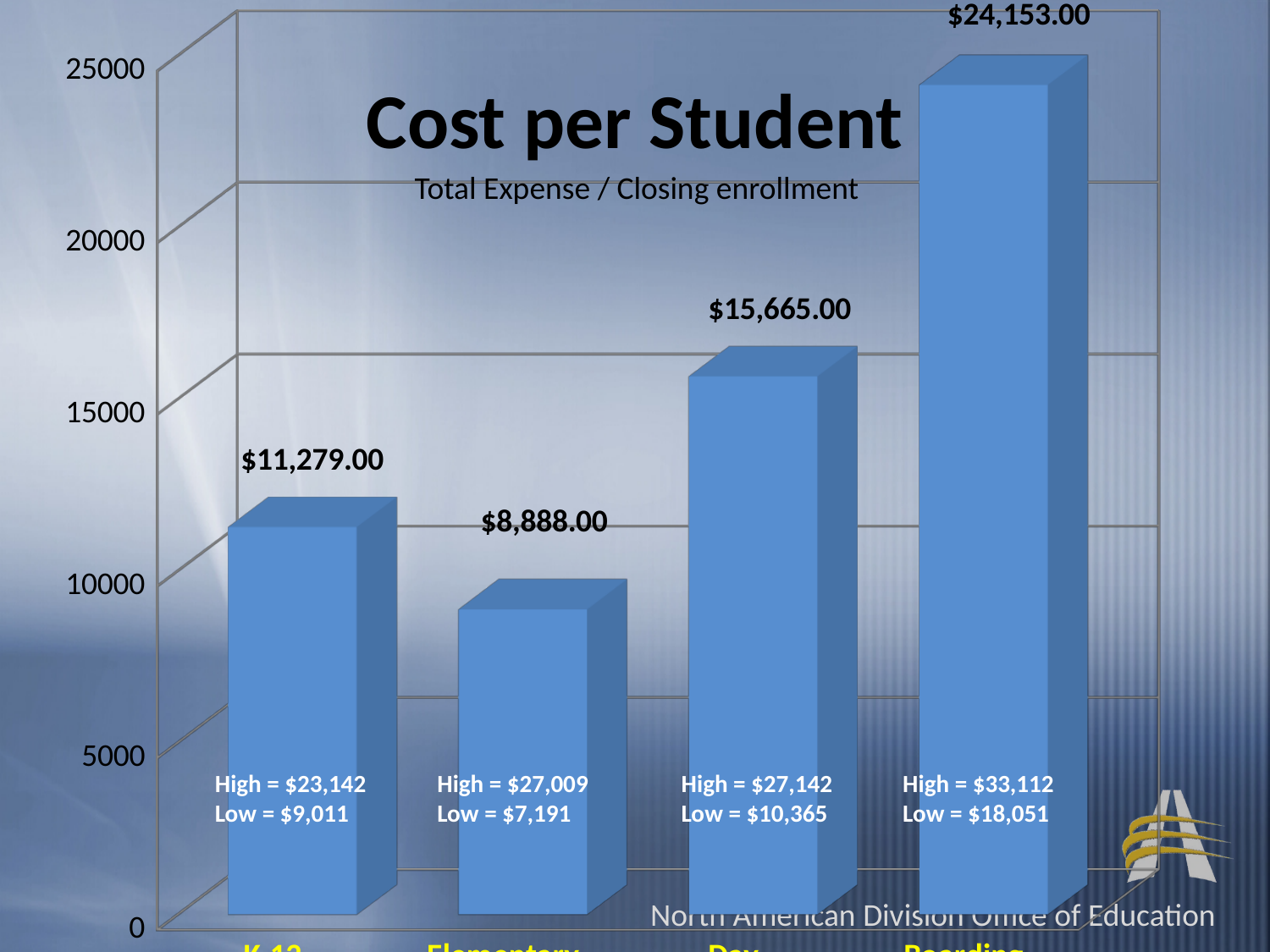
What is the value of the leftmost bar in the Cost per Student chart? $11,279.00 What is the subtitle shown under the chart title Cost per Student? Total Expense / Closing enrollment Which bar in the Cost per Student chart has the highest value? The rightmost (fourth) bar, $24,153.00 What is the value of the second bar from the left in the Cost per Student chart? $8,888.00 What is the value of the third bar from the left in the Cost per Student chart? $15,665.00 What type of chart is shown on the slide? Bar chart What is the value of the rightmost bar in the Cost per Student chart? $24,153.00 What is the difference between the rightmost bar and the third bar in the Cost per Student chart? $8,488.00 Which bar in the Cost per Student chart has the lowest value? The second bar from the left, $8,888.00 What is the difference between the leftmost bar and the second bar in the Cost per Student chart? $2,391.00 Which is larger in the Cost per Student chart, the leftmost bar or the third bar? The third bar How many bars are plotted in the Cost per Student chart? 4